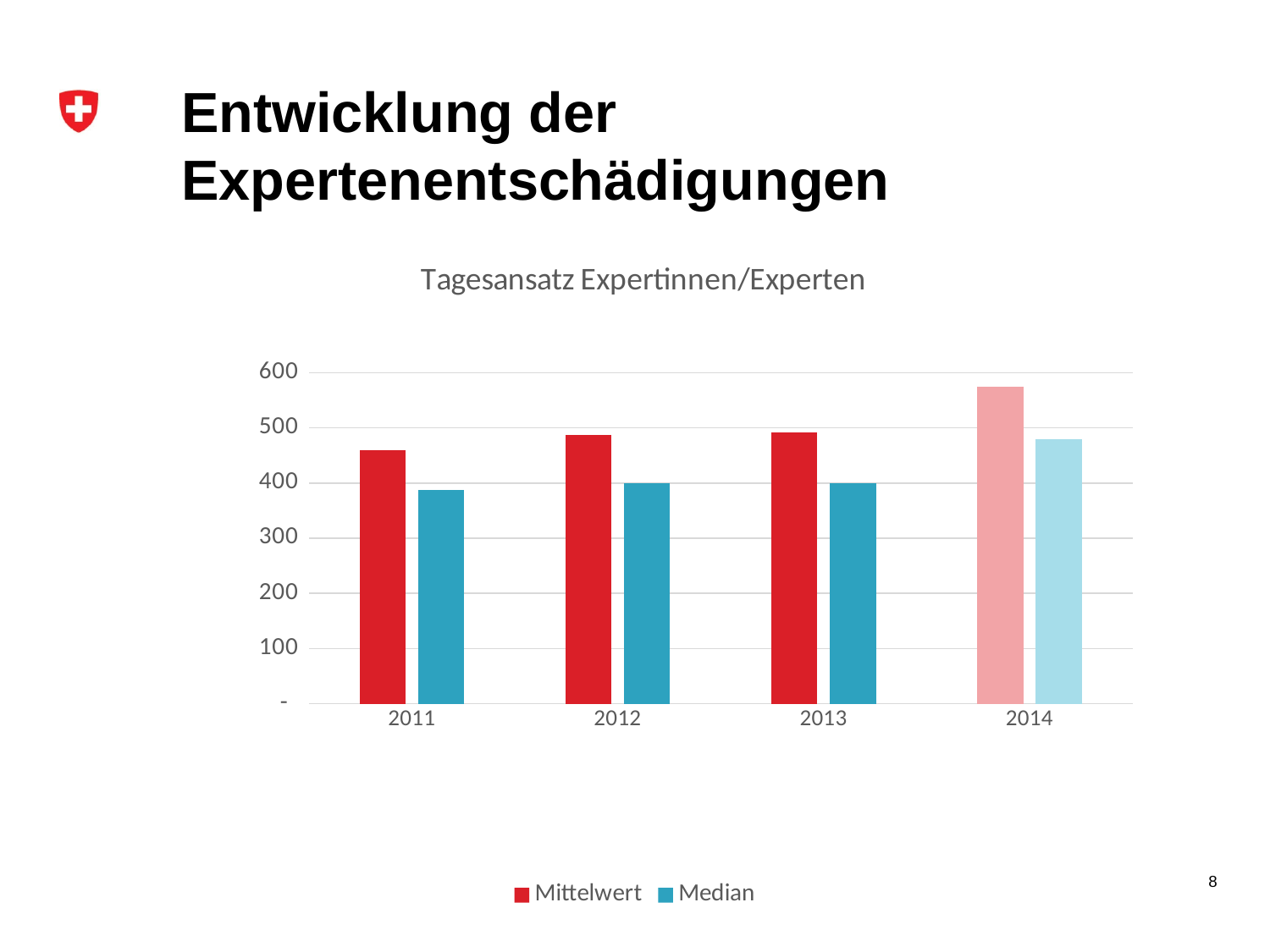
In which year is the Mittelwert highest? 2014 What is the title of the chart? Tagesansatz Expertinnen/Experten In 2013, which is larger, the Mittelwert or the Median? Mittelwert Is the Mittelwert for 2011 greater or less than 500? less Does the Mittelwert rise or fall from 2011 to 2014? rise What kind of chart is shown on the slide? bar chart Which series are listed in the legend? Mittelwert, Median In which year is the Median highest? 2014 Is the Mittelwert for 2014 greater or less than 500? greater Is the Median for 2014 greater or less than 500? less How many years are shown on the x axis? 4 How many series does the legend list? 2